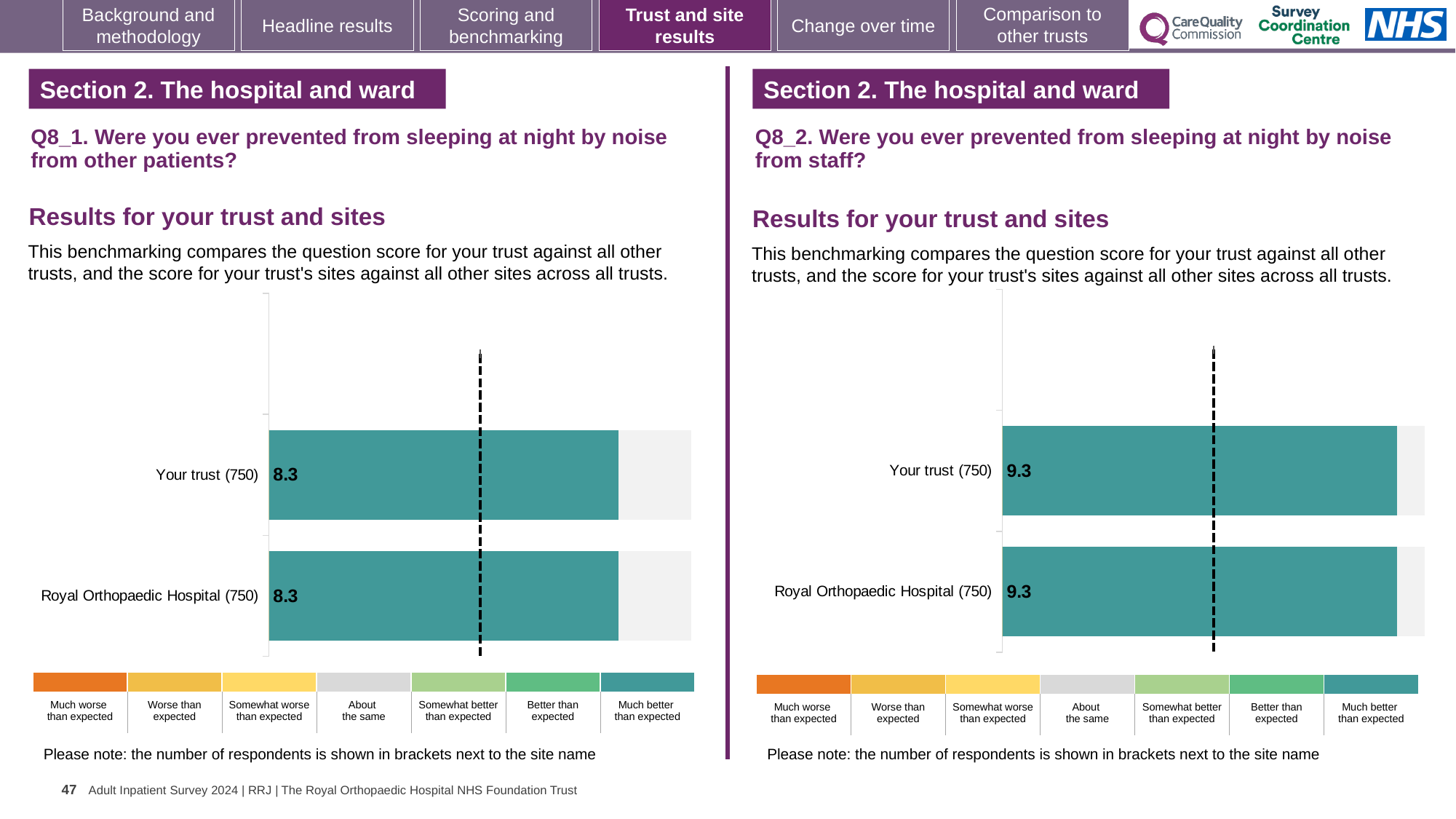
What kind of chart is used on the left side of the slide for Q8_1? Bar chart In the right chart (Q8_2, noise from staff), what is the score for Your trust (750)? 9.3 In the left chart (Q8_1, noise from other patients), what is the score for Royal Orthopaedic Hospital (750)? 8.3 How many respondents are shown in brackets for Your trust in the right chart (Q8_2)? 750 In the left chart (Q8_1), what is the difference between the score for Your trust and the score for Royal Orthopaedic Hospital? 0 How many bars are plotted in the left chart (Q8_1)? 2 In the left chart (Q8_1, noise from other patients), what is the score for Your trust (750)? 8.3 In the right chart (Q8_2), what is the difference between the score for Your trust and the score for Royal Orthopaedic Hospital? 0 According to the colour key, which benchmark category does the teal colour of the bars in the right chart (Q8_2) represent? Much better than expected How many bars are plotted in the right chart (Q8_2)? 2 In the right chart (Q8_2, noise from staff), what is the score for Royal Orthopaedic Hospital (750)? 9.3 How many benchmark categories does the colour key below the left chart (Q8_1) list? 7